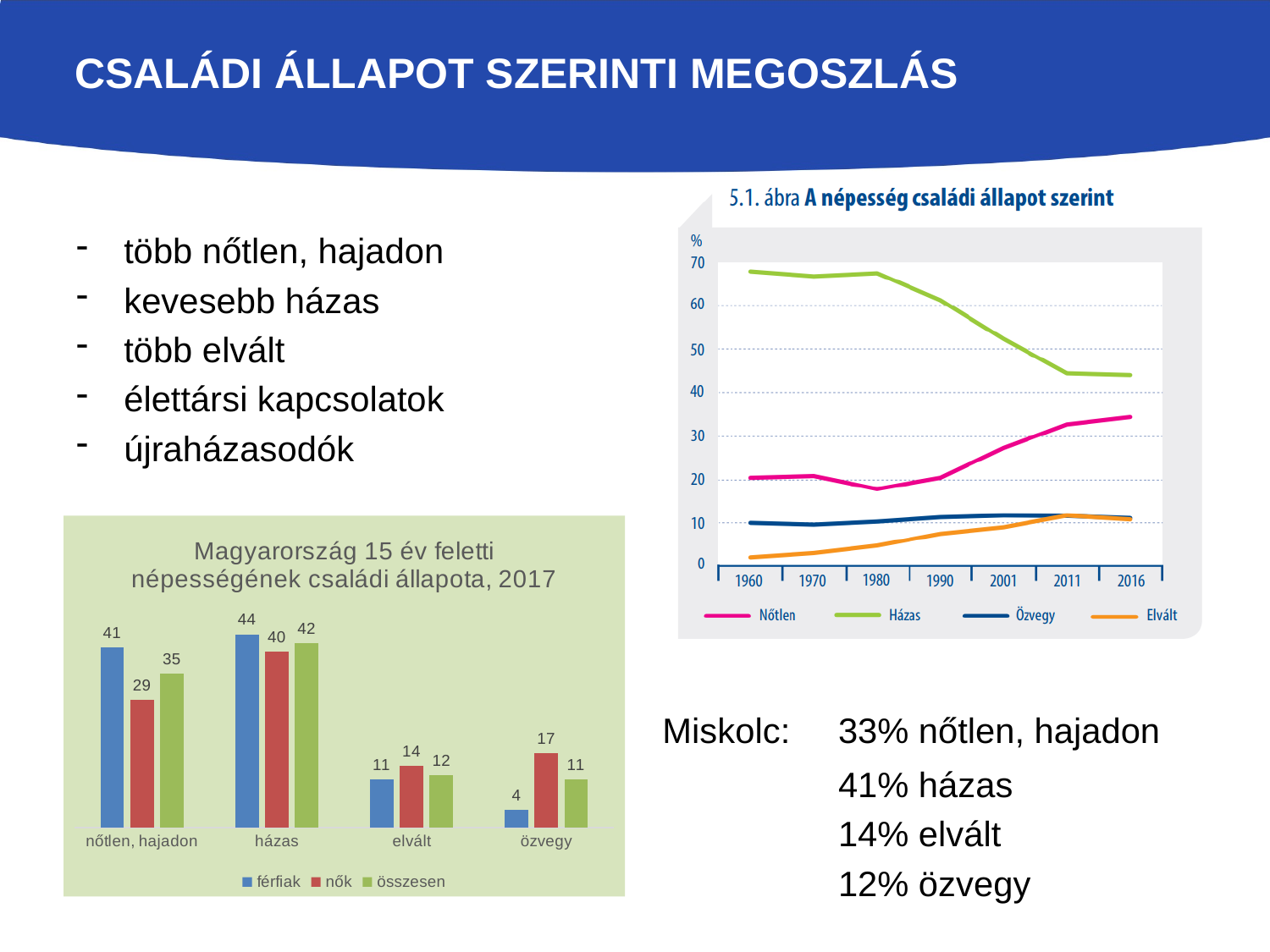
In the line chart '5.1. ábra A népesség családi állapot szerint', does the Házas series rise or fall from 1960 to 2016? fall In the bar chart 'Magyarország 15 év feletti népességének családi állapota, 2017', which is larger in the elvált category: férfiak or nők? nők In the bar chart 'Magyarország 15 év feletti népességének családi állapota, 2017', which category has the highest value for összesen? házas What kind of chart is the chart titled '5.1. ábra A népesség családi állapot szerint'? line chart In the bar chart 'Magyarország 15 év feletti népességének családi állapota, 2017', what is the value for férfiak in the házas category? 44 In the line chart '5.1. ábra A népesség családi állapot szerint', is the value for Nőtlen in 2016 greater or less than 30? greater How many series does the legend of the line chart '5.1. ábra A népesség családi állapot szerint' list? 4 In the bar chart 'Magyarország 15 év feletti népességének családi állapota, 2017', what is the value for nők in the özvegy category? 17 In the bar chart 'Magyarország 15 év feletti népességének családi állapota, 2017', what is the difference between férfiak and nők in the nőtlen, hajadon category? 12 How many categories are shown on the x axis of the bar chart 'Magyarország 15 év feletti népességének családi állapota, 2017'? 4 In the bar chart 'Magyarország 15 év feletti népességének családi állapota, 2017', which category has the lowest value for férfiak? özvegy How many series does the legend of the bar chart 'Magyarország 15 év feletti népességének családi állapota, 2017' list? 3